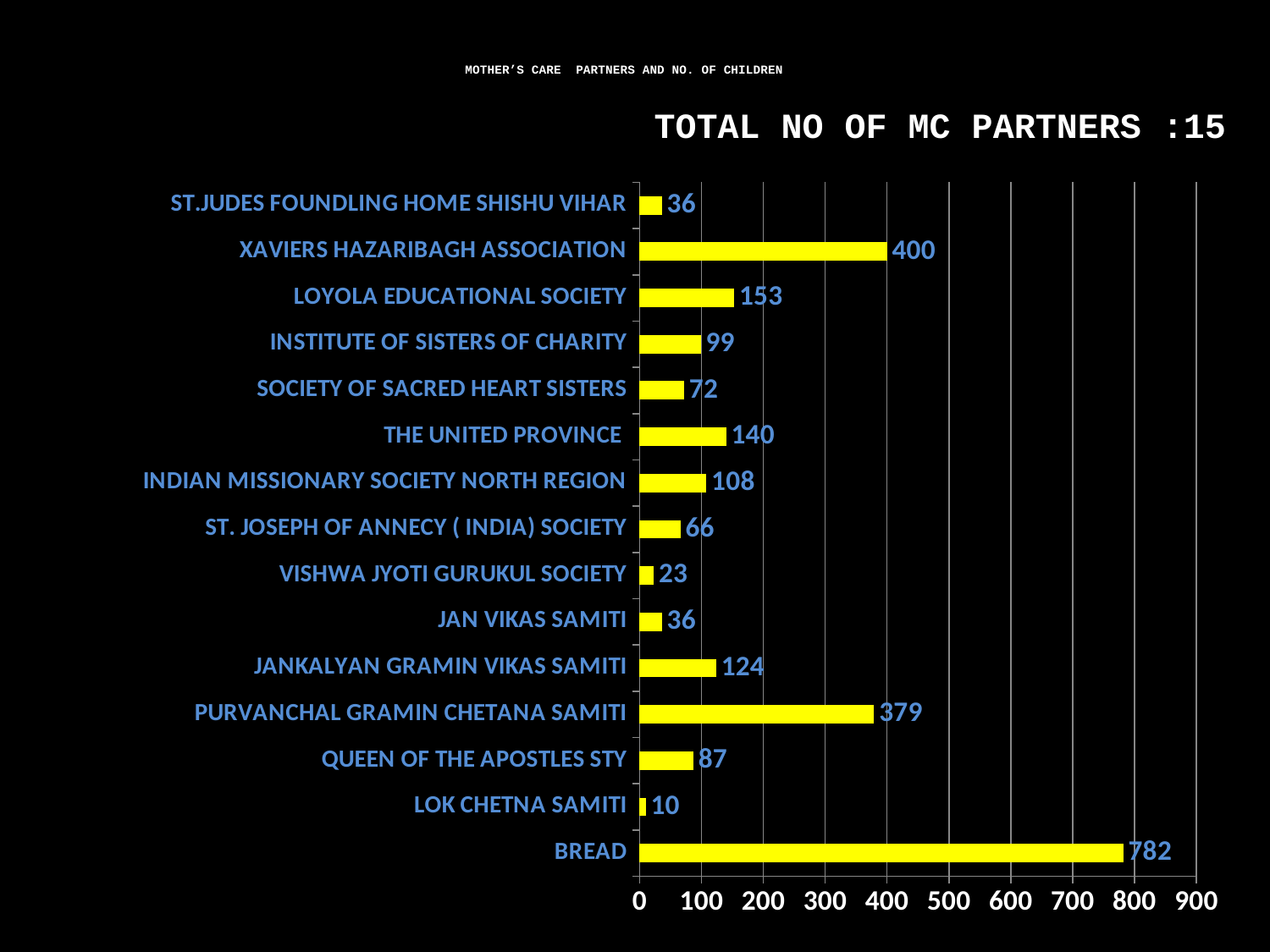
What is the difference between the values for BREAD and XAVIERS HAZARIBAGH ASSOCIATION? 382 How many children does BREAD have according to the chart? 782 What is the value shown for LOK CHETNA SAMITI? 10 What colour are the bars in the chart? yellow Which partner has the lowest number of children? LOK CHETNA SAMITI What is the value shown for XAVIERS HAZARIBAGH ASSOCIATION? 400 What is the difference between the values for JANKALYAN GRAMIN VIKAS SAMITI and JAN VIKAS SAMITI? 88 Is the value for THE UNITED PROVINCE greater or less than 100? greater How many partners are plotted in the chart? 15 What kind of chart is shown on the slide? bar chart Which partner has the highest number of children? BREAD Which has a larger value, PURVANCHAL GRAMIN CHETANA SAMITI or LOYOLA EDUCATIONAL SOCIETY? PURVANCHAL GRAMIN CHETANA SAMITI